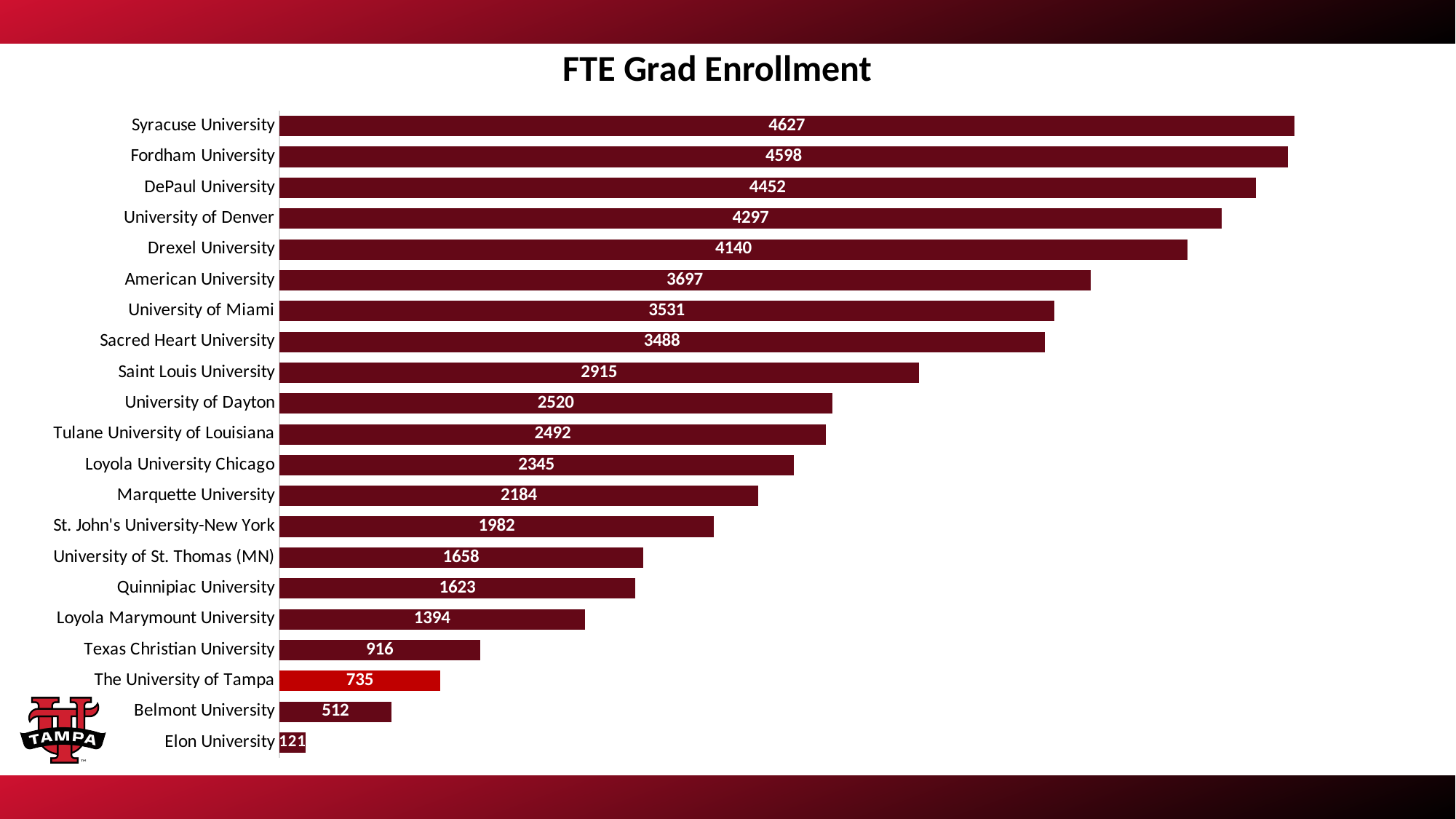
What is the FTE grad enrollment for Drexel University? 4140 Which university has the lowest FTE grad enrollment? Elon University Which has a larger FTE grad enrollment, Texas Christian University or Quinnipiac University? Quinnipiac University What is the difference in FTE grad enrollment between The University of Tampa and Belmont University? 223 What kind of chart is shown on the slide? Bar chart Which university's bar is highlighted in a brighter red colour than the others? The University of Tampa What is the FTE grad enrollment for Loyola Marymount University? 1394 Which has a larger FTE grad enrollment, University of Miami or Sacred Heart University? University of Miami What is the difference in FTE grad enrollment between Syracuse University and Fordham University? 29 What is the FTE grad enrollment for The University of Tampa? 735 Which university has the highest FTE grad enrollment? Syracuse University How many universities are shown in the chart? 21